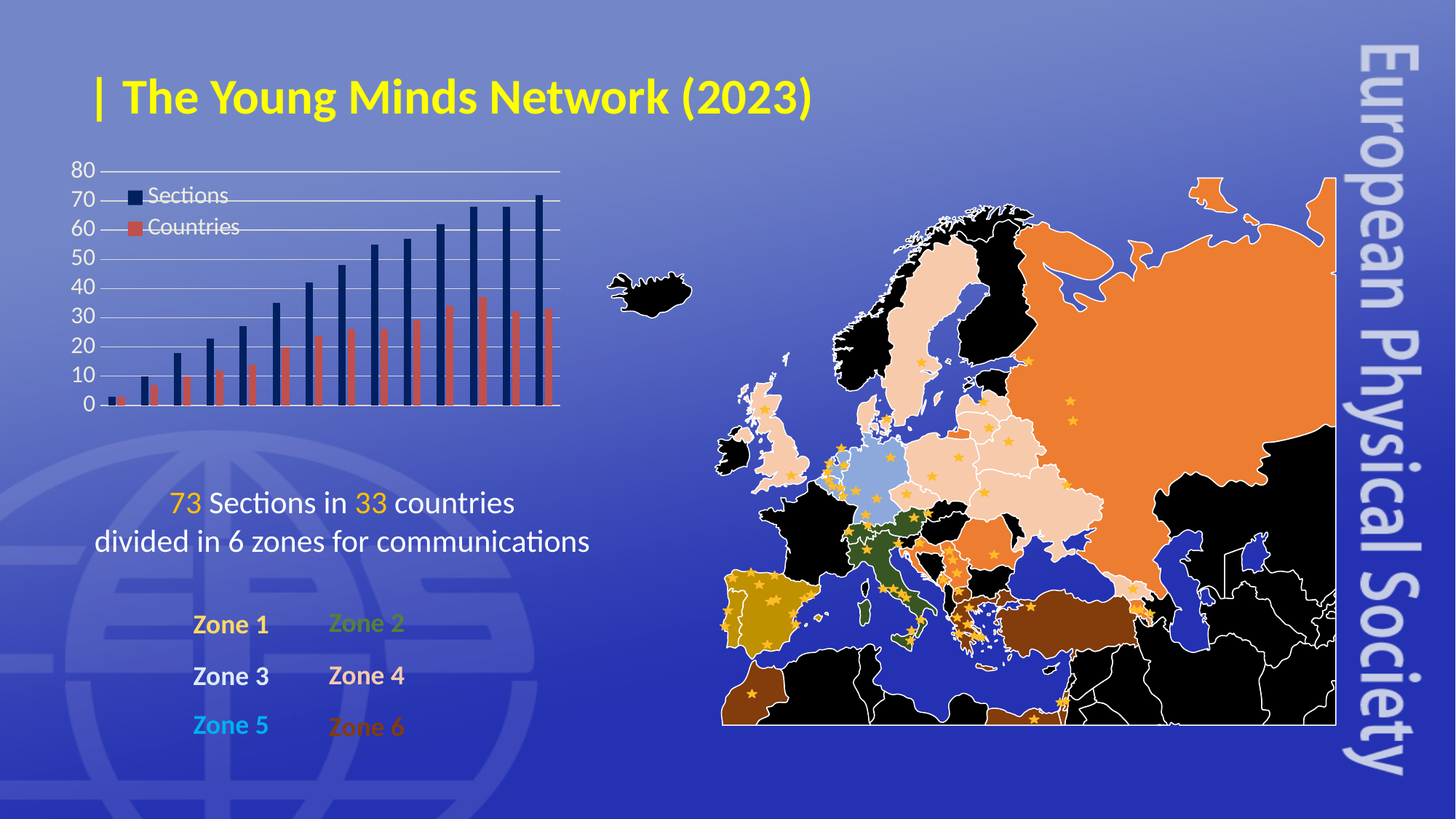
What kind of chart is shown on the slide? bar chart Is the tallest Countries bar greater or less than 40? less Do the Sections values rise or fall from left to right along the x axis? rise Is the rightmost Sections bar greater or less than 60? greater How many pairs of bars are plotted in the chart? 14 Which colour represents the Sections series in the chart? dark blue Is the leftmost Sections bar greater or less than 10? less How many series does the chart legend list? 2 In the rightmost pair of bars, which series has the larger value, Sections or Countries? Sections What are the two series named in the chart legend? Sections and Countries Do the Countries values generally rise or fall from left to right along the x axis? rise